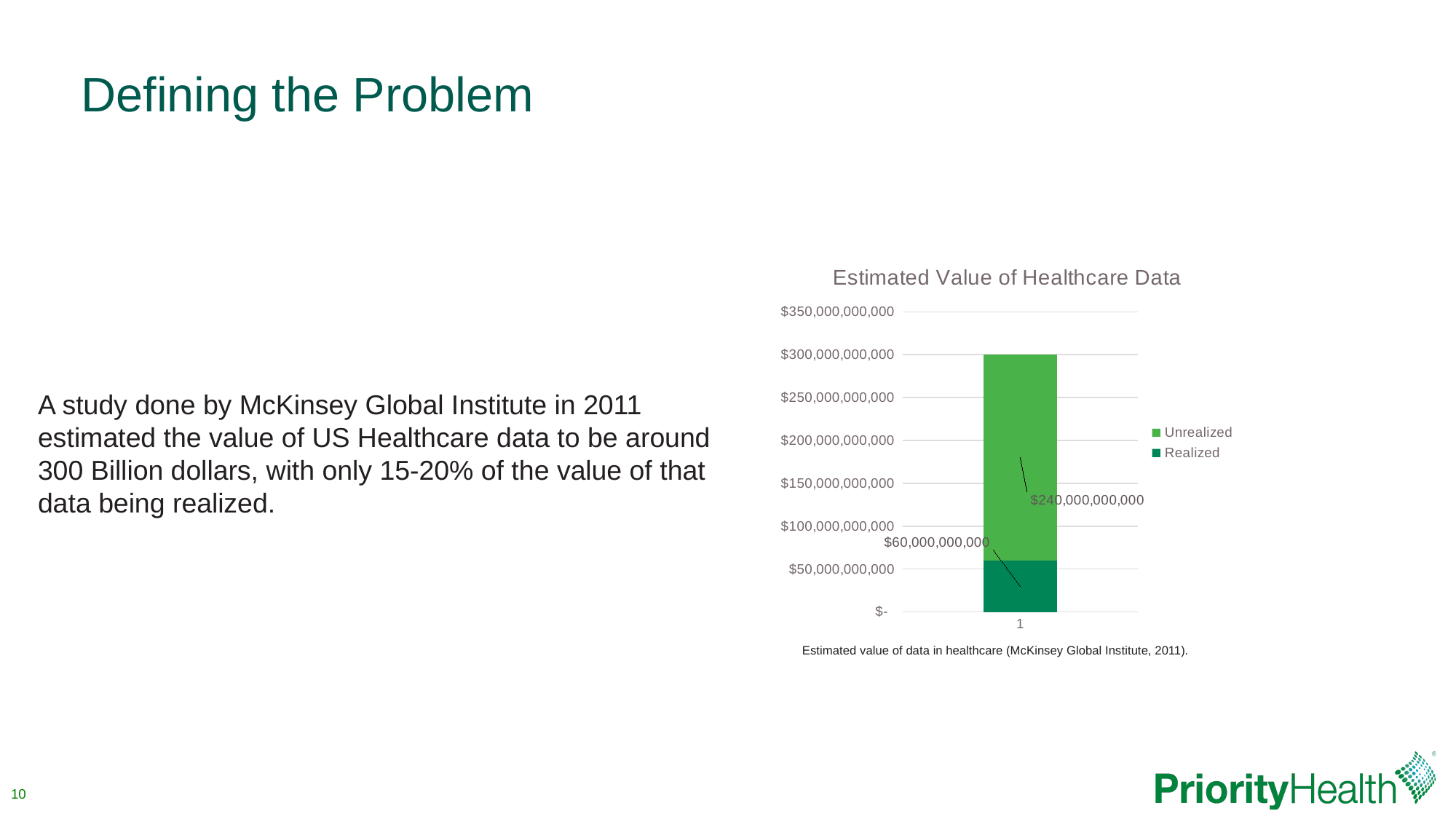
What kind of chart is shown on the slide? Stacked bar chart What is the value of the Unrealized segment of the bar? $240,000,000,000 Which series has the larger value, Unrealized or Realized? Unrealized Is the Realized value greater or less than $100,000,000,000? less How many series does the chart legend list? 2 How many bars (categories) are plotted in the chart? 1 Is the Unrealized value greater or less than $200,000,000,000? greater What is the title of the chart? Estimated Value of Healthcare Data What are the two series named in the chart legend? Unrealized and Realized What is the difference between the Unrealized and Realized values? $180,000,000,000 What is the value of the Realized segment of the bar? $60,000,000,000 What is the total value of the stacked bar? $300,000,000,000